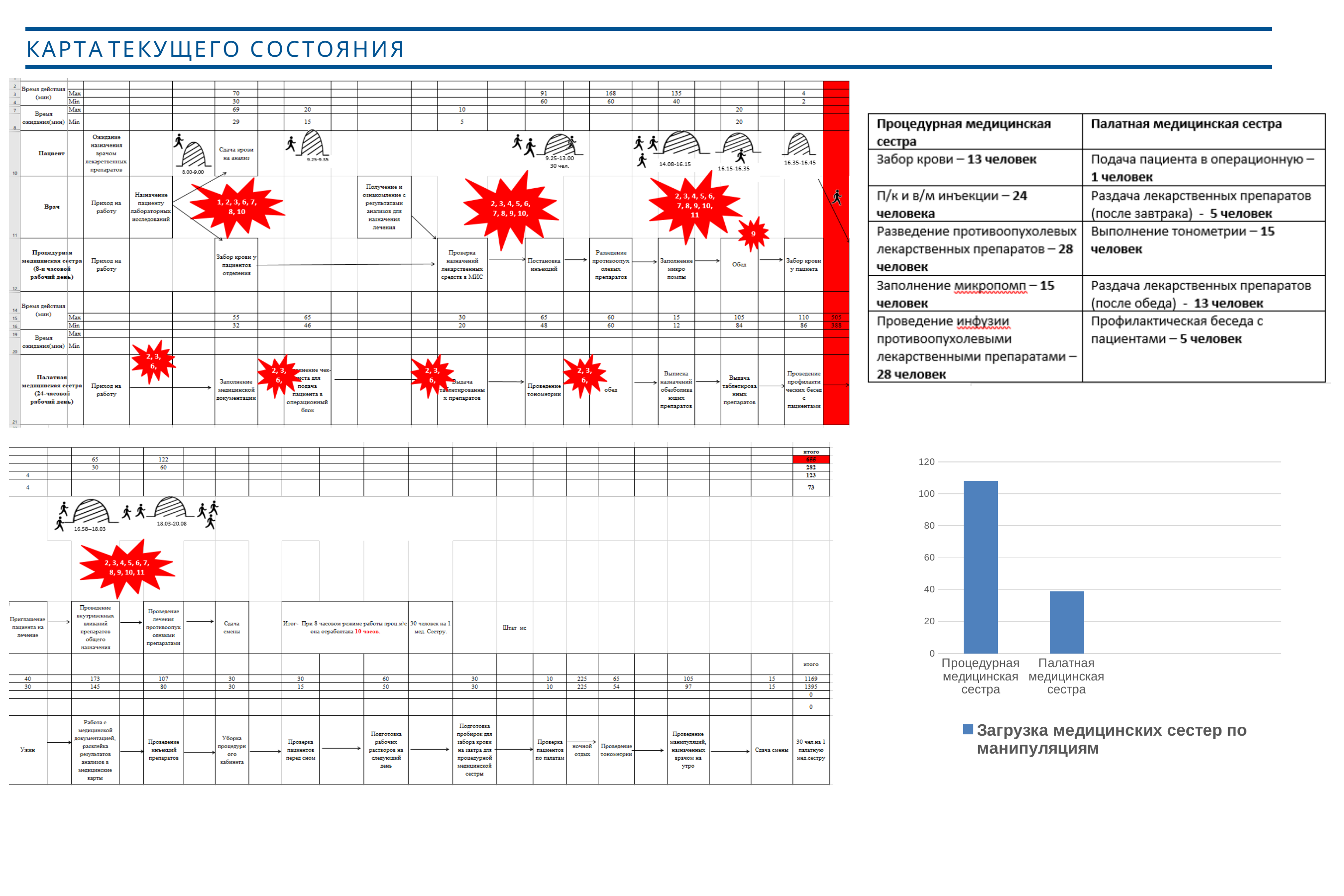
Is the value for Процедурная медицинская сестра in the bar chart greater or less than 120? less What kind of chart is shown at the bottom right of the slide? bar chart How many categories does the bar chart show? 2 What is the legend entry of the bar chart? Загрузка медицинских сестер по манипуляциям Is the value for Палатная медицинская сестра in the bar chart greater or less than 60? less How many series does the legend of the bar chart list? 1 What is the highest tick value shown on the vertical axis of the bar chart? 120 In the bar chart, which is larger: the value for Процедурная медицинская сестра or for Палатная медицинская сестра? Процедурная медицинская сестра Is the value for Процедурная медицинская сестра in the bar chart greater or less than 100? greater Which category has the highest value in the bar chart? Процедурная медицинская сестра Which category has the lowest value in the bar chart? Палатная медицинская сестра